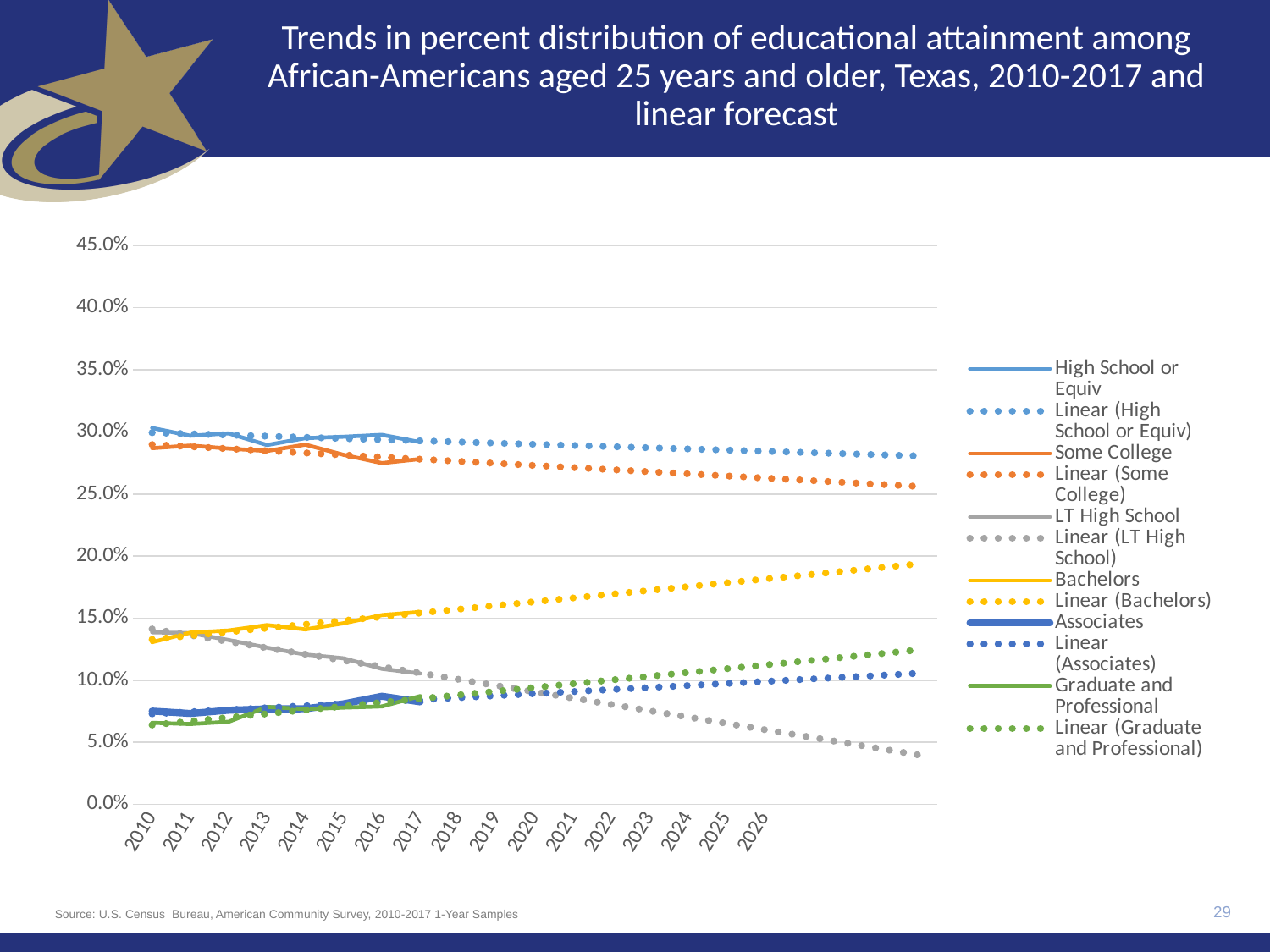
How many years are labelled on the x axis? 17 Is the value for Associates in 2010 greater or less than 10.0%? less Is the value for Some College in 2010 greater or less than 30.0%? less Which series has the lowest value in 2010? Graduate and Professional In 2017, which is larger: Bachelors or LT High School? Bachelors What kind of chart is shown on the slide? line chart Does the LT High School series rise or fall from 2010 to 2017? fall Does the Bachelors series rise or fall from 2010 to 2017? rise How many entries does the legend list? 12 Which series has the highest value in 2010? High School or Equiv What is the first year shown on the x axis? 2010